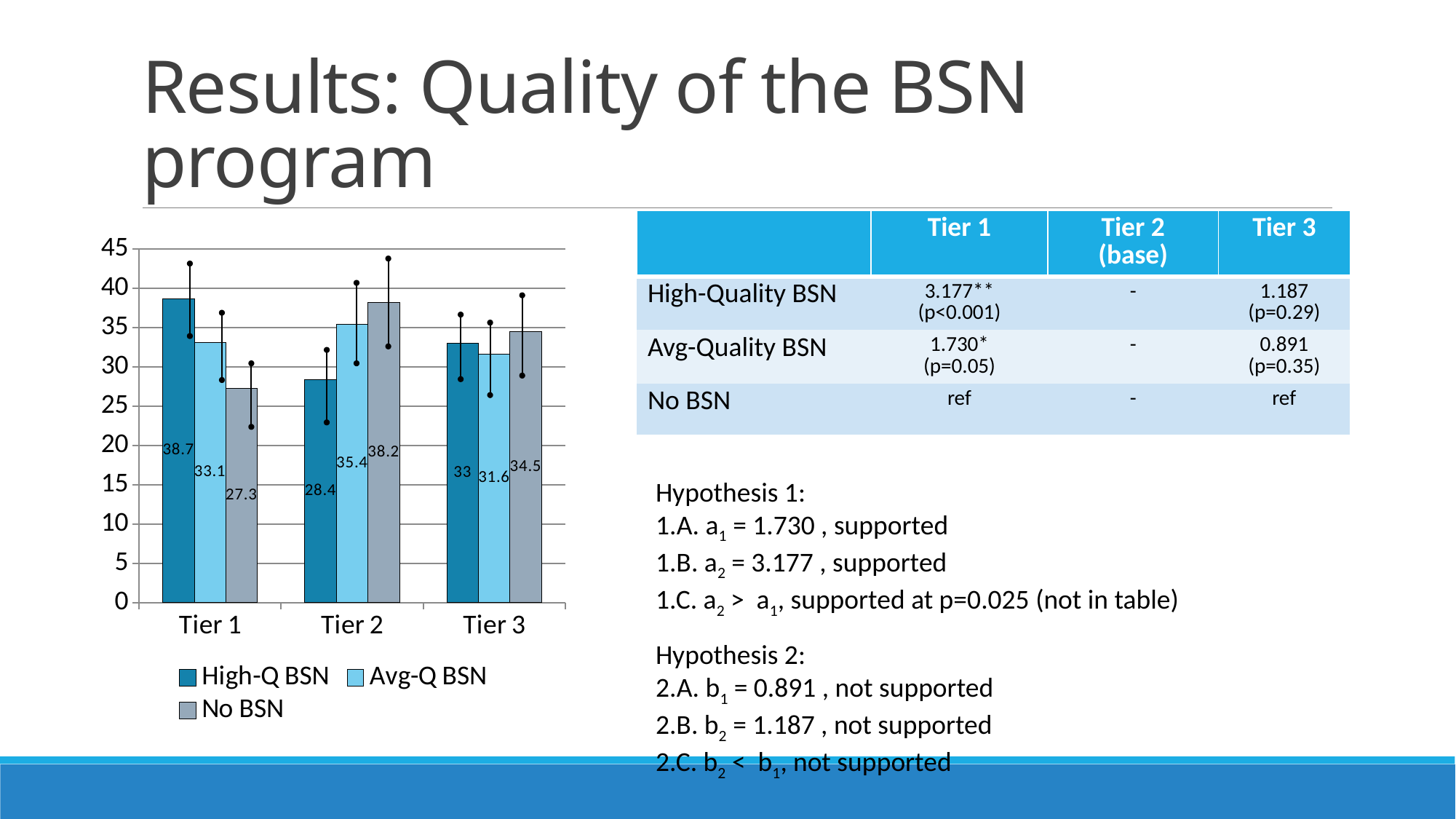
How many tiers are shown on the x axis of the chart? 3 Which tier has the lowest value for No BSN? Tier 1 What is the value for High-Q BSN in Tier 1? 38.7 How many series does the chart legend list? 3 What is the value for Avg-Q BSN in Tier 3? 31.6 Which series is shown in the darkest blue colour in the chart? High-Q BSN In Tier 2, which is larger: High-Q BSN or No BSN? No BSN What is the value for No BSN in Tier 2? 38.2 Is the value for Avg-Q BSN in Tier 2 greater or less than 30? greater What kind of chart is shown on the slide? bar chart Which tier has the highest value for High-Q BSN? Tier 1 What is the difference between the High-Q BSN and No BSN values in Tier 1? 11.4